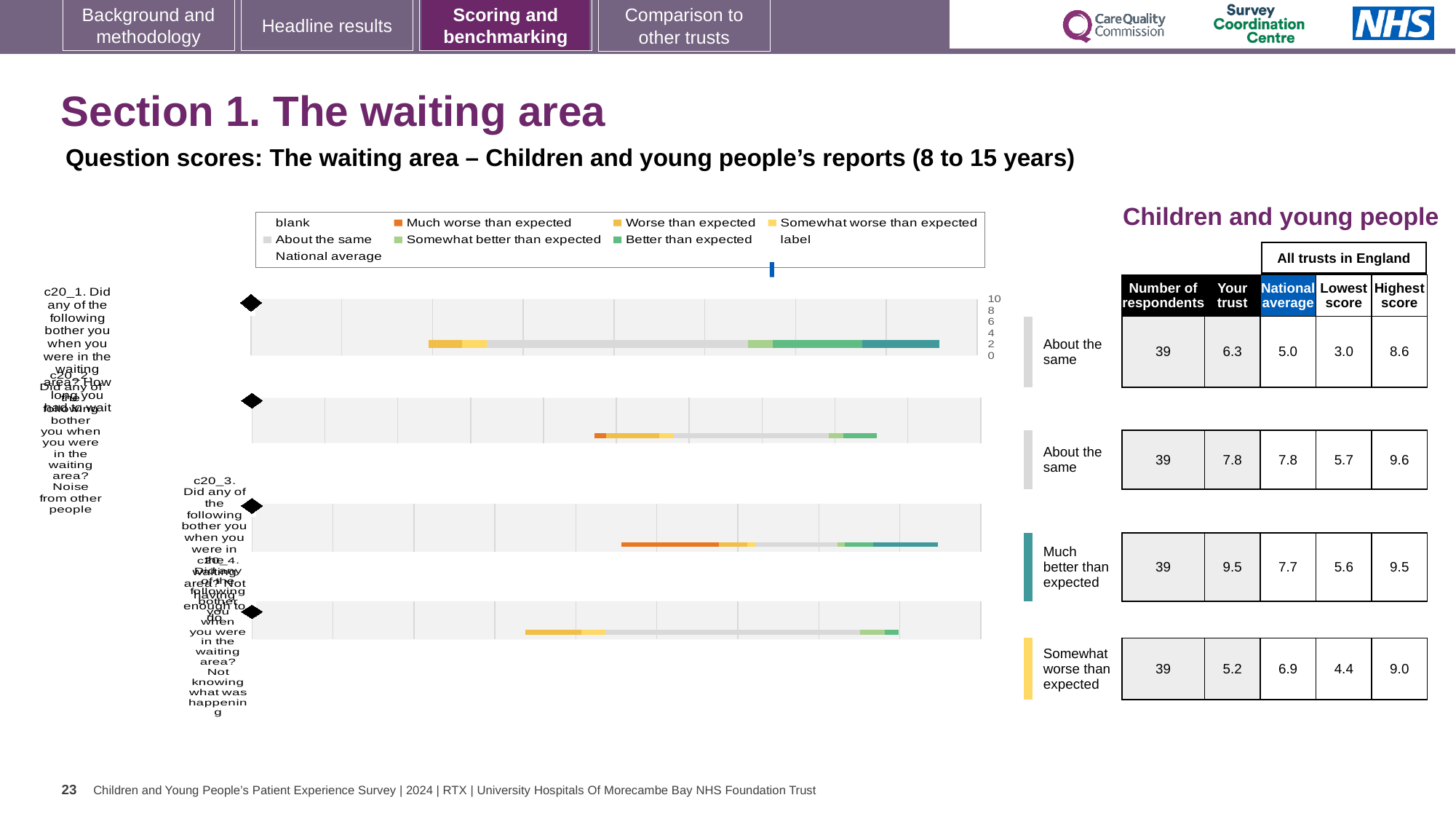
Which of the four questions has the lowest 'Your trust' score in the table? the fourth question (Somewhat worse than expected), 5.2 In the table beside the charts, what is the highest score for the second question? 9.6 In the table beside the charts, what is the national average for the top (first) question? 5.0 What kind of chart is used to show the question scores on this slide? bar chart In the table beside the charts, what is the 'Your trust' score for the third question (rated 'Much better than expected')? 9.5 Which of the four questions has the highest 'Your trust' score in the table? the third question (Much better than expected), 9.5 In the legend, what colour represents 'Much worse than expected'? orange For the fourth question, which is larger in the table: the 'Your trust' score or the national average? national average In the legend, what colour represents 'Better than expected'? teal green For the top (first) question, what is the difference between the 'Your trust' score and the national average in the table? 1.3 In the table beside the charts, how many respondents are listed for the top (first) question? 39 How many question bars (charts) are plotted on the slide? 4